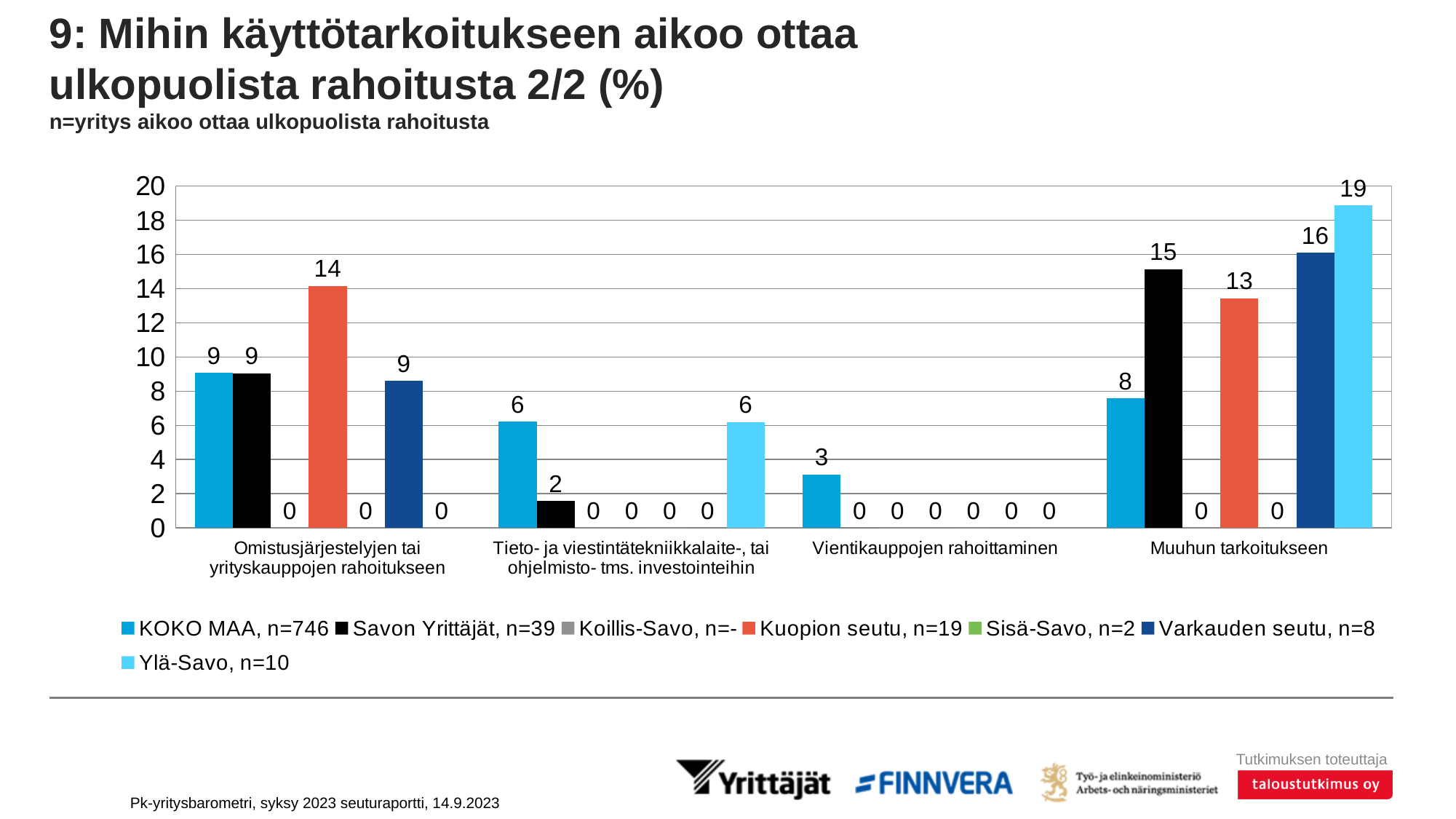
How many series does the legend list? 7 What is the value for Kuopion seutu in the category Omistusjärjestelyjen tai yrityskauppojen rahoitukseen? 14 What is the value for KOKO MAA in the category Vientikauppojen rahoittaminen? 3 What is the difference between the Varkauden seutu and KOKO MAA values in the category Muuhun tarkoitukseen? 8 What is the value for Savon Yrittäjät in the category Tieto- ja viestintätekniikkalaite-, tai ohjelmisto- tms. investointeihin? 2 In which category does KOKO MAA have its lowest value? Vientikauppojen rahoittaminen What is the value for Ylä-Savo in the category Muuhun tarkoitukseen? 19 What kind of chart is shown on the slide? Bar chart Which series has the highest value in the category Muuhun tarkoitukseen? Ylä-Savo What is the sample size (n) given in the legend for Kuopion seutu? 19 How many categories are shown on the x axis? 4 In the category Muuhun tarkoitukseen, which is larger: Savon Yrittäjät or Kuopion seutu? Savon Yrittäjät